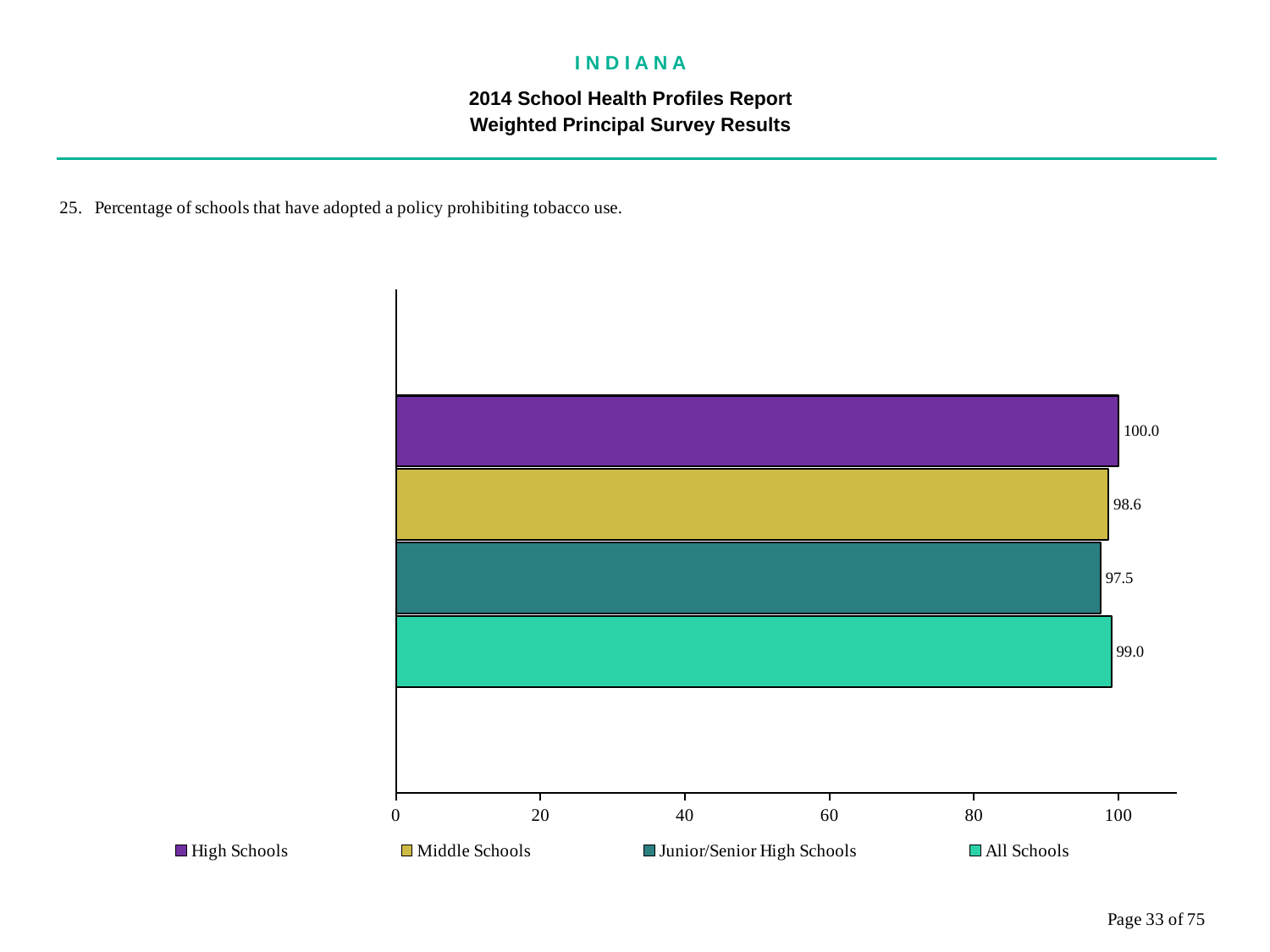
Which category has the highest value? High Schools What is the difference between the values for All Schools and Middle Schools? 0.4 Which is larger, the value for Middle Schools or the value for Junior/Senior High Schools? Middle Schools Which category has the lowest value? Junior/Senior High Schools How many bars are plotted in the chart? 4 What is the value for Junior/Senior High Schools? 97.5 What is the difference between the values for High Schools and Junior/Senior High Schools? 2.5 What is the value for High Schools? 100.0 What kind of chart is shown on the slide? Bar chart What is the value for All Schools? 99.0 What is the value for Middle Schools? 98.6 How many entries does the legend list? 4